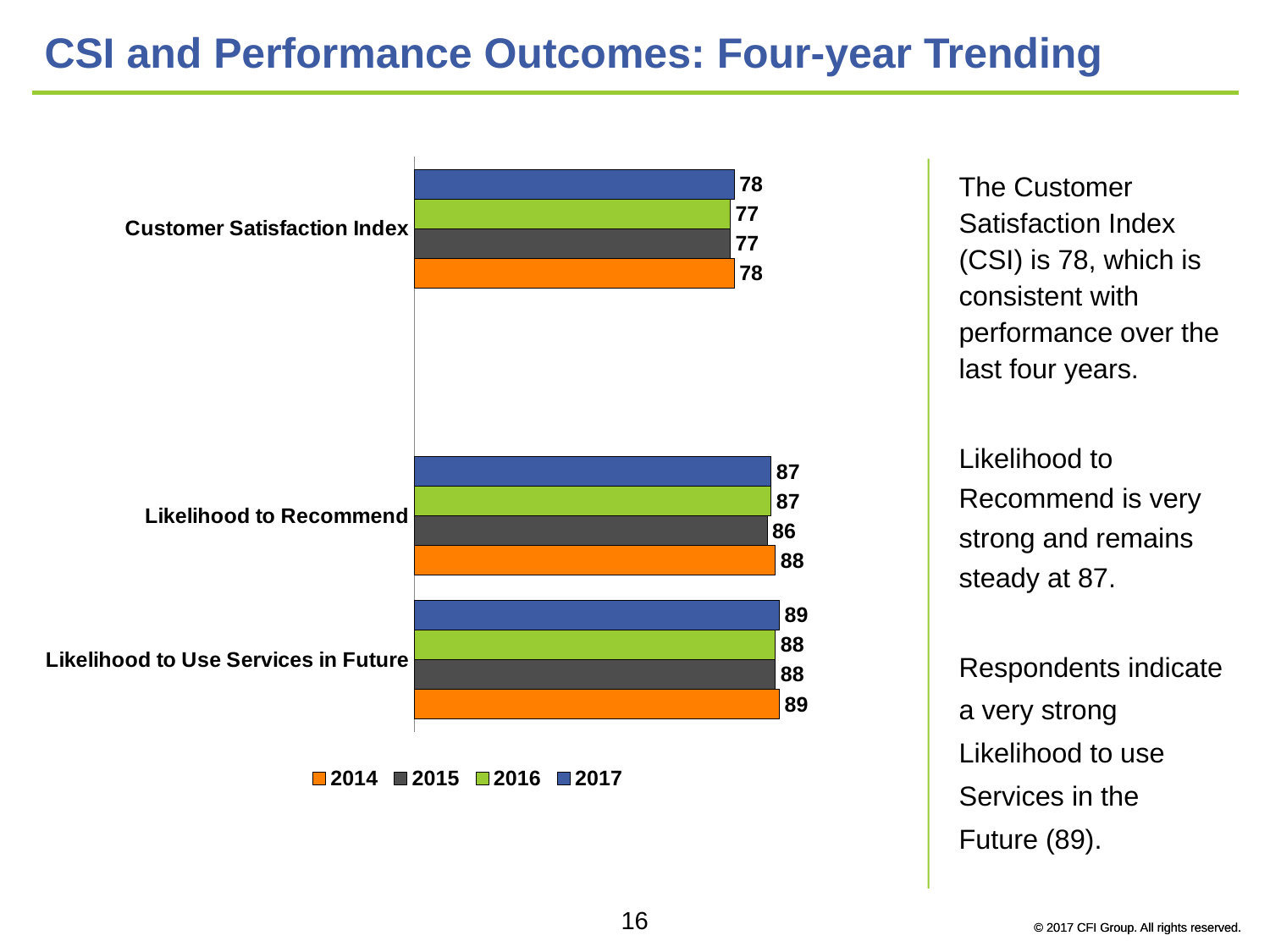
What kind of chart is shown on the slide? Bar chart What is the 2015 value for Likelihood to Recommend? 86 What is the 2016 value for Customer Satisfaction Index? 77 Which category has the lowest 2014 value? Customer Satisfaction Index What is the 2014 value for Likelihood to Use Services in Future? 89 How many series does the legend list? 4 How many categories are shown on the chart? 3 Which year does the orange series in the legend represent? 2014 What is the 2017 value for Customer Satisfaction Index? 78 What is the difference between the 2017 values for Likelihood to Use Services in Future and Customer Satisfaction Index? 11 Which is larger for Likelihood to Recommend: the 2014 value or the 2015 value? 2014 Which category has the highest 2017 value? Likelihood to Use Services in Future